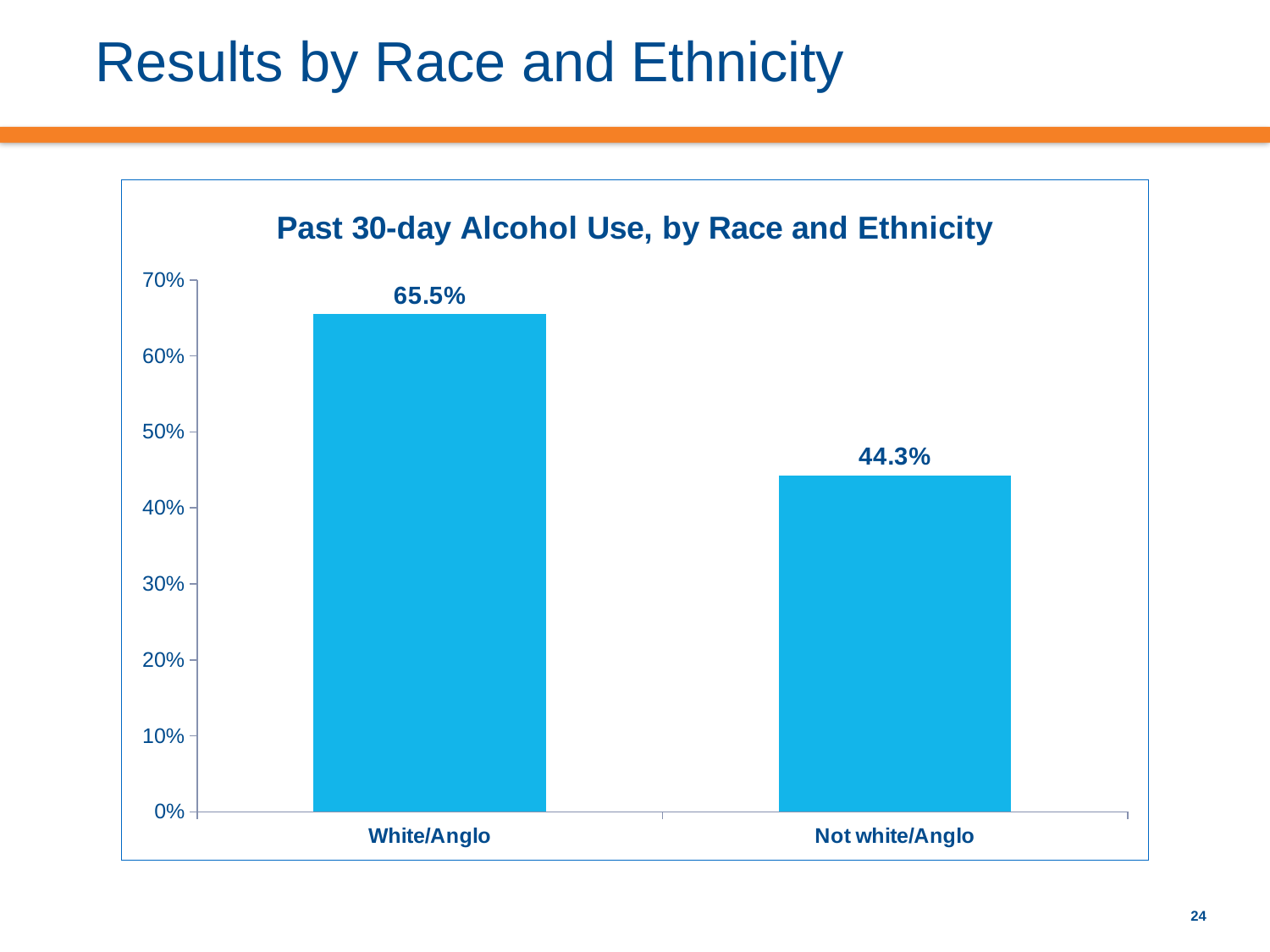
What kind of chart is shown on the slide? Bar chart What is the highest value shown on the y axis? 70% How many categories are shown on the x axis? 2 What is the past 30-day alcohol use value for White/Anglo? 65.5% Is the value for White/Anglo greater or less than 60%? greater What is the past 30-day alcohol use value for Not white/Anglo? 44.3% Is the value for Not white/Anglo greater or less than 50%? less Which category has the lowest past 30-day alcohol use? Not white/Anglo Which category has the highest past 30-day alcohol use? White/Anglo Which is larger, the value for White/Anglo or the value for Not white/Anglo? White/Anglo What is the difference in past 30-day alcohol use between White/Anglo and Not white/Anglo? 21.2% What is the title of the chart? Past 30-day Alcohol Use, by Race and Ethnicity